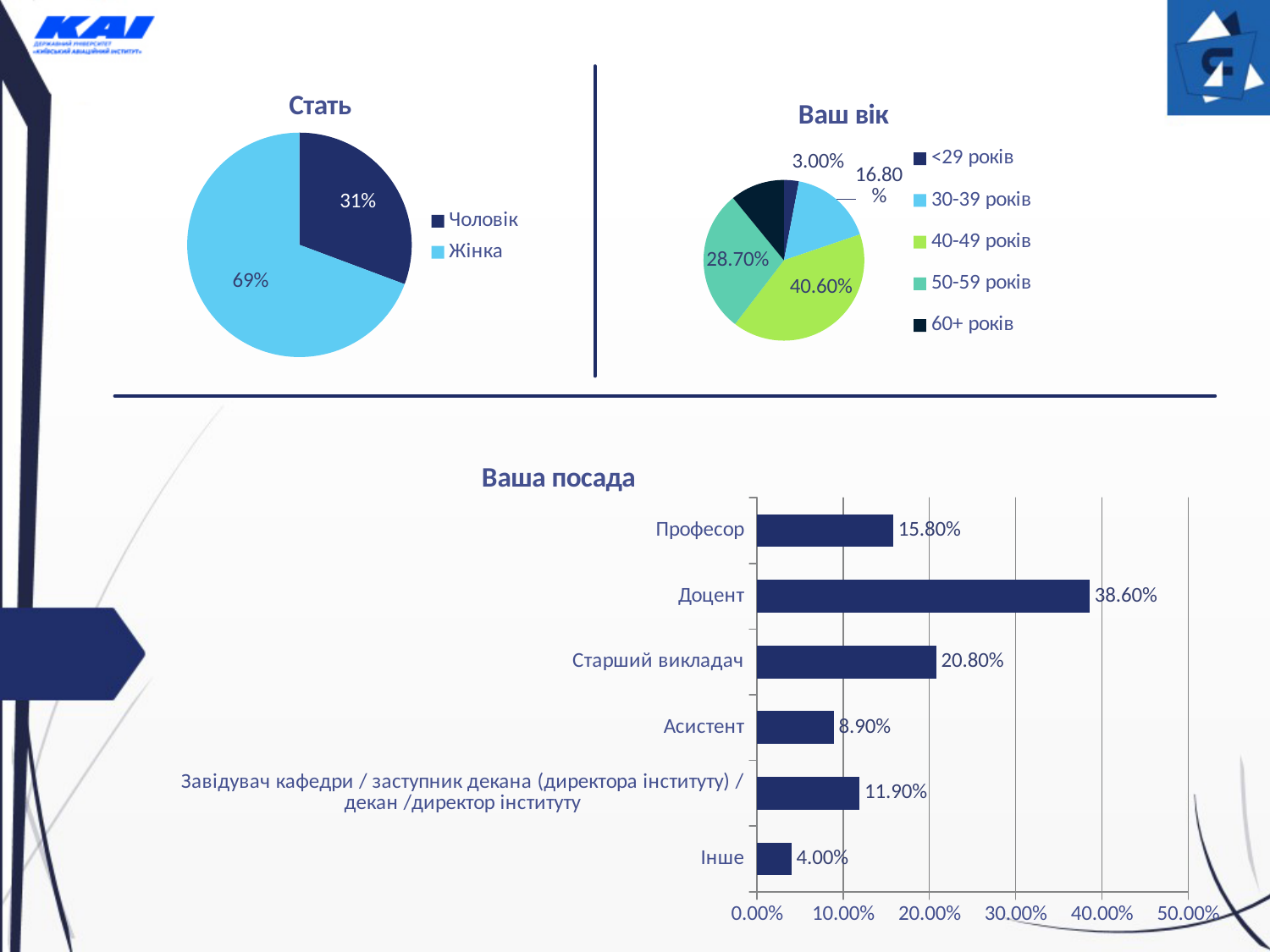
In the "Ваша посада" chart, what is the difference between Старший викладач and Професор? 5.00% In the "Ваша посада" chart, what is the value for Доцент? 38.60% In the "Ваш вік" pie chart, what value is labelled for the 50-59 років slice? 28.70% In the "Ваш вік" pie chart, how many age groups does the legend list? 5 In the "Ваша посада" chart, how many categories are shown? 6 In the "Ваша посада" chart, which category has the lowest value? Інше In the "Стать" pie chart, how many entries does the legend list? 2 In the "Стать" pie chart, what share is labelled for Жінка? 69% In the "Ваш вік" pie chart, what value is labelled for the 40-49 років slice? 40.60% In the "Стать" pie chart, what share is labelled for Чоловік? 31% In the "Ваш вік" pie chart, which age group has the largest slice? 40-49 років What kind of chart is "Ваша посада"? Bar chart